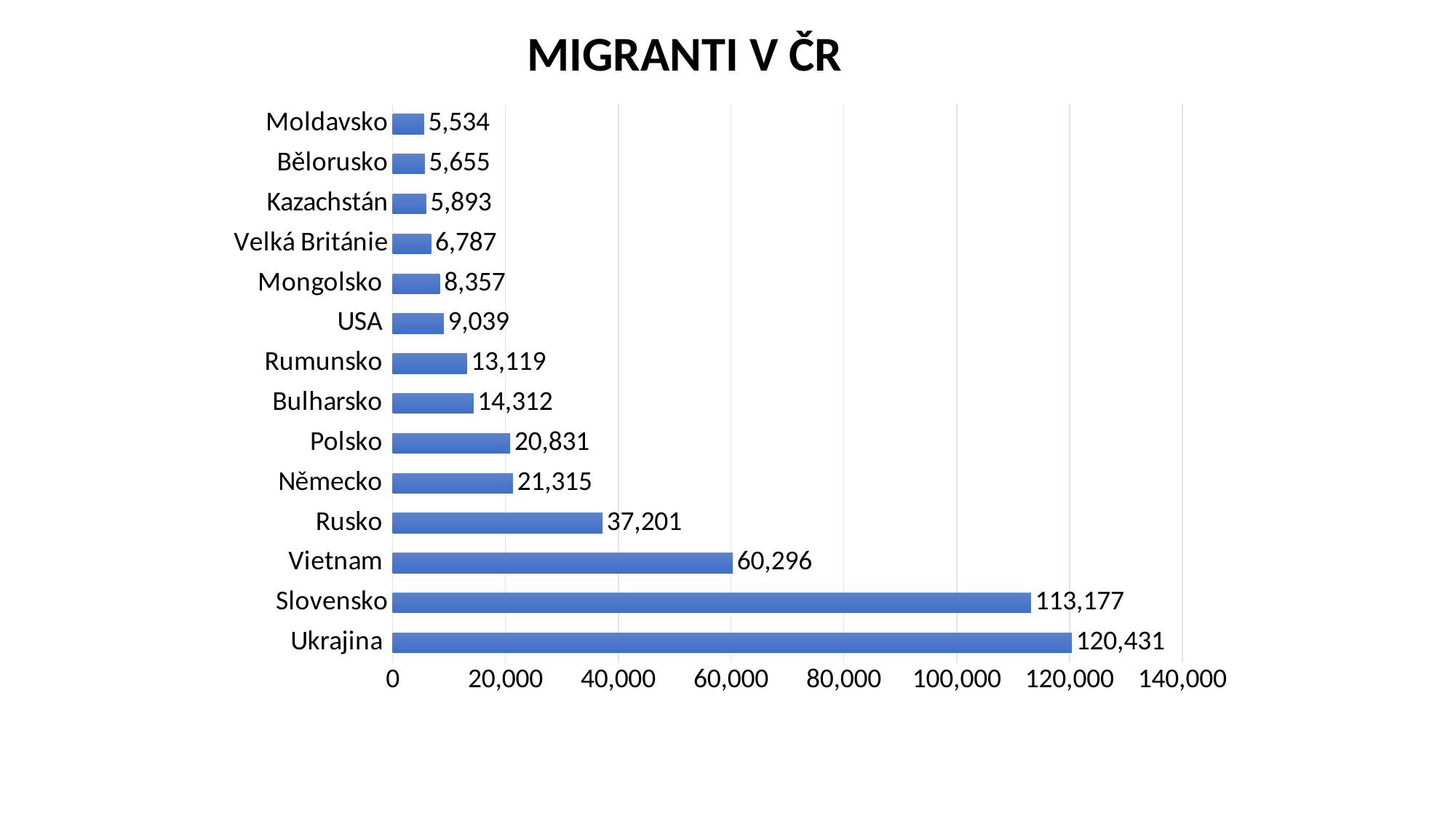
What is the title of the chart? MIGRANTI V ČR What is the value for Mongolsko? 8,357 What is the difference between the values for Rusko and Německo? 15,886 What is the value for Vietnam? 60,296 What is the value for Ukrajina? 120,431 Which country has the highest value? Ukrajina What kind of chart is shown on the slide? bar chart Which country has the lowest value? Moldavsko How many countries are shown in the chart? 14 Is the value for Vietnam greater or less than 40,000? greater What is the difference between the values for Ukrajina and Slovensko? 7,254 Which is larger, the value for Polsko or the value for Bulharsko? Polsko